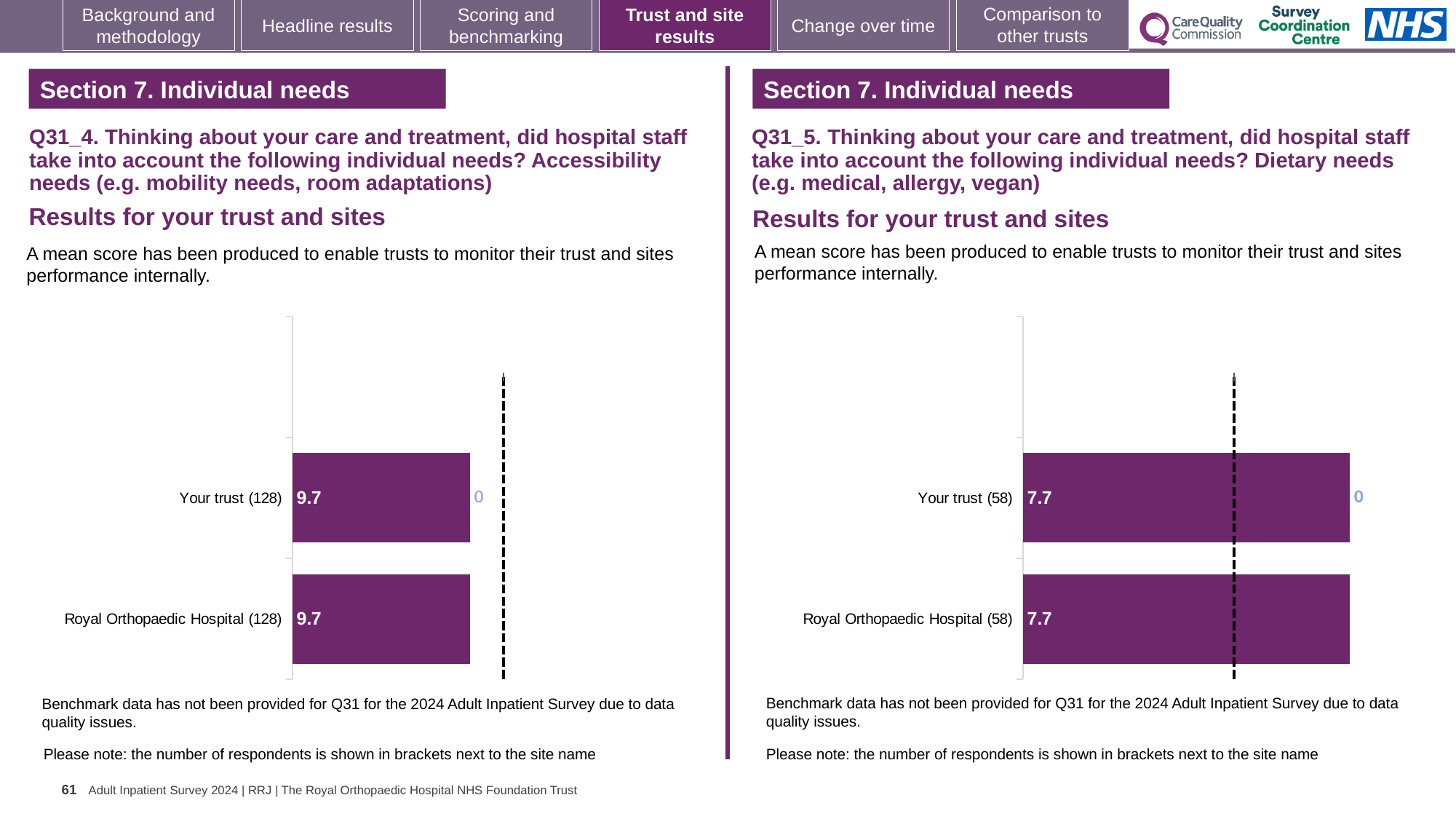
In the Q31_4 chart (Accessibility needs) on the left, what is the value for Your trust? 9.7 In the Q31_4 chart (Accessibility needs) on the left, what is the value for Royal Orthopaedic Hospital? 9.7 Is the value for Your trust in the Q31_4 chart on the left larger than the value for Your trust in the Q31_5 chart on the right? Yes How many bars are plotted in the Q31_5 chart on the right? 2 In the Q31_4 chart on the left, how many respondents are shown in brackets next to Royal Orthopaedic Hospital? 128 In the Q31_5 chart (Dietary needs) on the right, what is the value for Your trust? 7.7 How many bars are plotted in the Q31_4 chart on the left? 2 In the Q31_5 chart on the right, how many respondents are shown in brackets next to Your trust? 58 In the Q31_4 chart on the left, what is the difference between the values for Your trust and Royal Orthopaedic Hospital? 0 In the Q31_5 chart on the right, what is the difference between the values for Your trust and Royal Orthopaedic Hospital? 0 What kind of chart is used for the Q31_4 results on the left? Bar chart In the Q31_5 chart (Dietary needs) on the right, what is the value for Royal Orthopaedic Hospital? 7.7